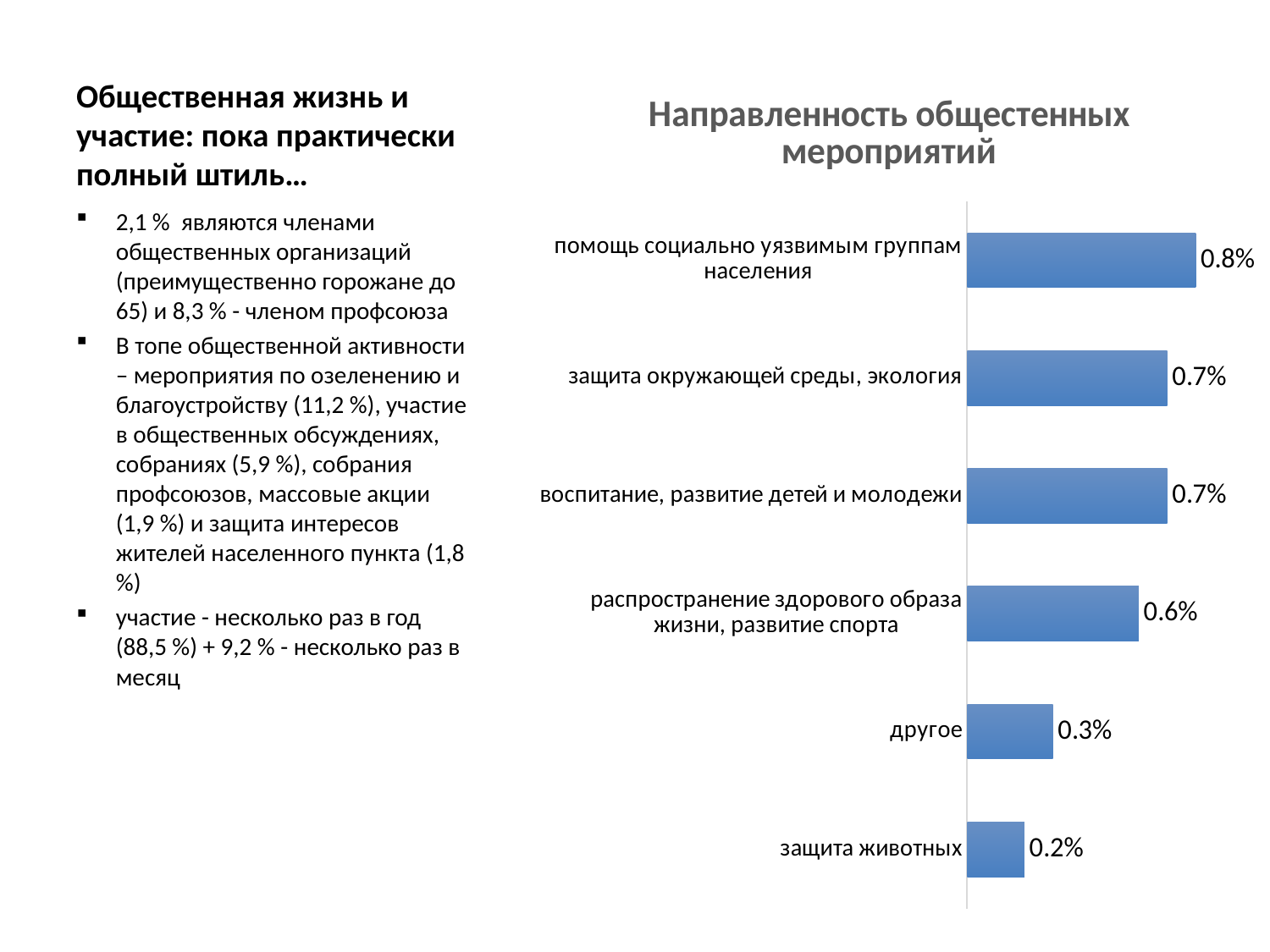
What is the value for 'помощь социально уязвимым группам населения'? 0.8% What kind of chart is shown on the slide? bar chart Which category has the highest value? помощь социально уязвимым группам населения What is the value for 'защита животных'? 0.2% What is the difference between the values for 'воспитание, развитие детей и молодежи' and 'другое'? 0.4% What is the title of the chart? Направленность общестенных мероприятий What is the difference between the values for 'помощь социально уязвимым группам населения' and 'защита животных'? 0.6% What is the value for 'распространение здорового образа жизни, развитие спорта'? 0.6% How many categories are shown in the chart? 6 What is the value for 'другое'? 0.3% Which category has the lowest value? защита животных Which is larger: the value for 'другое' or the value for 'защита окружающей среды, экология'? защита окружающей среды, экология